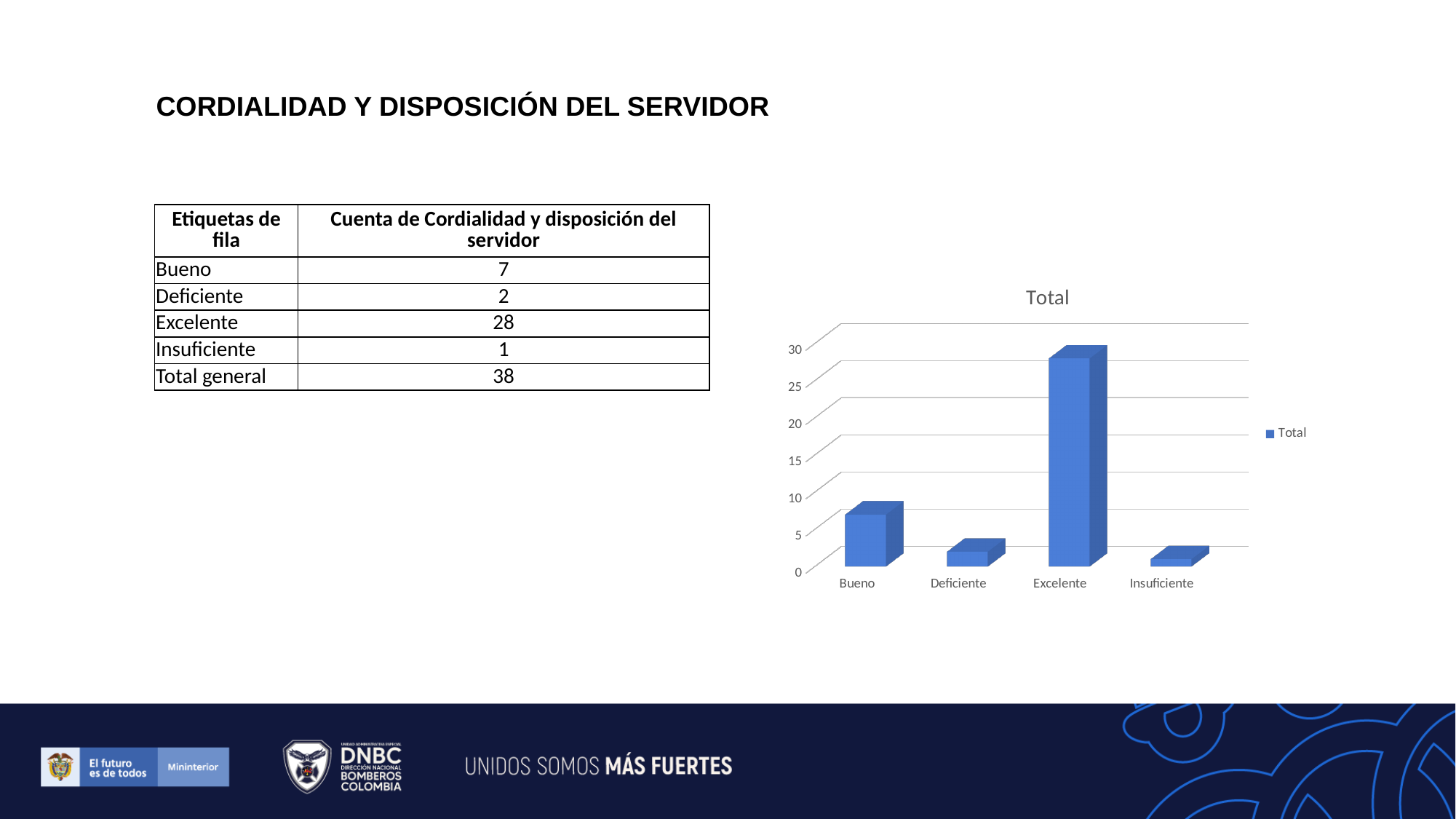
Which category has the highest bar in the chart? Excelente Is the value for Bueno greater or less than 10? less What is the title of the chart? Total How many series does the chart legend list? 1 Is the value for Deficiente greater or less than 5? less Which is larger, the value for Bueno or the value for Deficiente? Bueno How many categories are shown on the x axis of the chart? 4 According to the slide, what is the difference between the values for Excelente and Bueno? 21 What type of chart is shown on the slide? bar chart Is the value for Excelente greater or less than 25? greater Which category has the lowest bar in the chart? Insuficiente According to the slide, what is the value for Excelente? 28